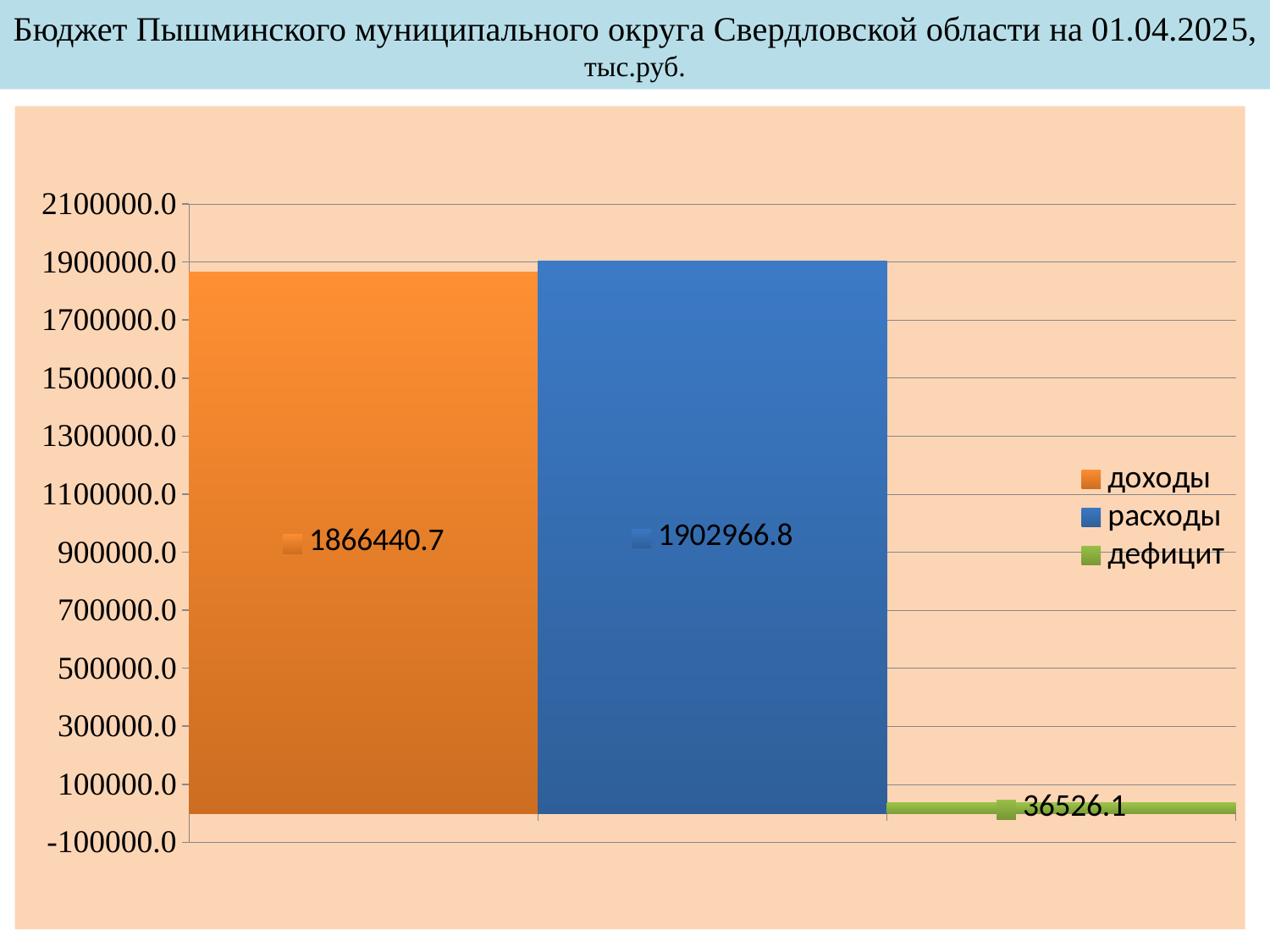
What kind of chart is shown on the slide? bar chart Which is larger, доходы or расходы? расходы Is the value for дефицит greater or less than 100000.0? less What is the value for расходы? 1902966.8 Which series has the lowest value? дефицит What is the value for дефицит? 36526.1 Which series has the highest value? расходы What is the value for доходы? 1866440.7 What colour is the bar for расходы? blue What is the difference between расходы and доходы? 36526.1 Is the value for доходы greater or less than 1700000.0? greater How many series does the legend list? 3